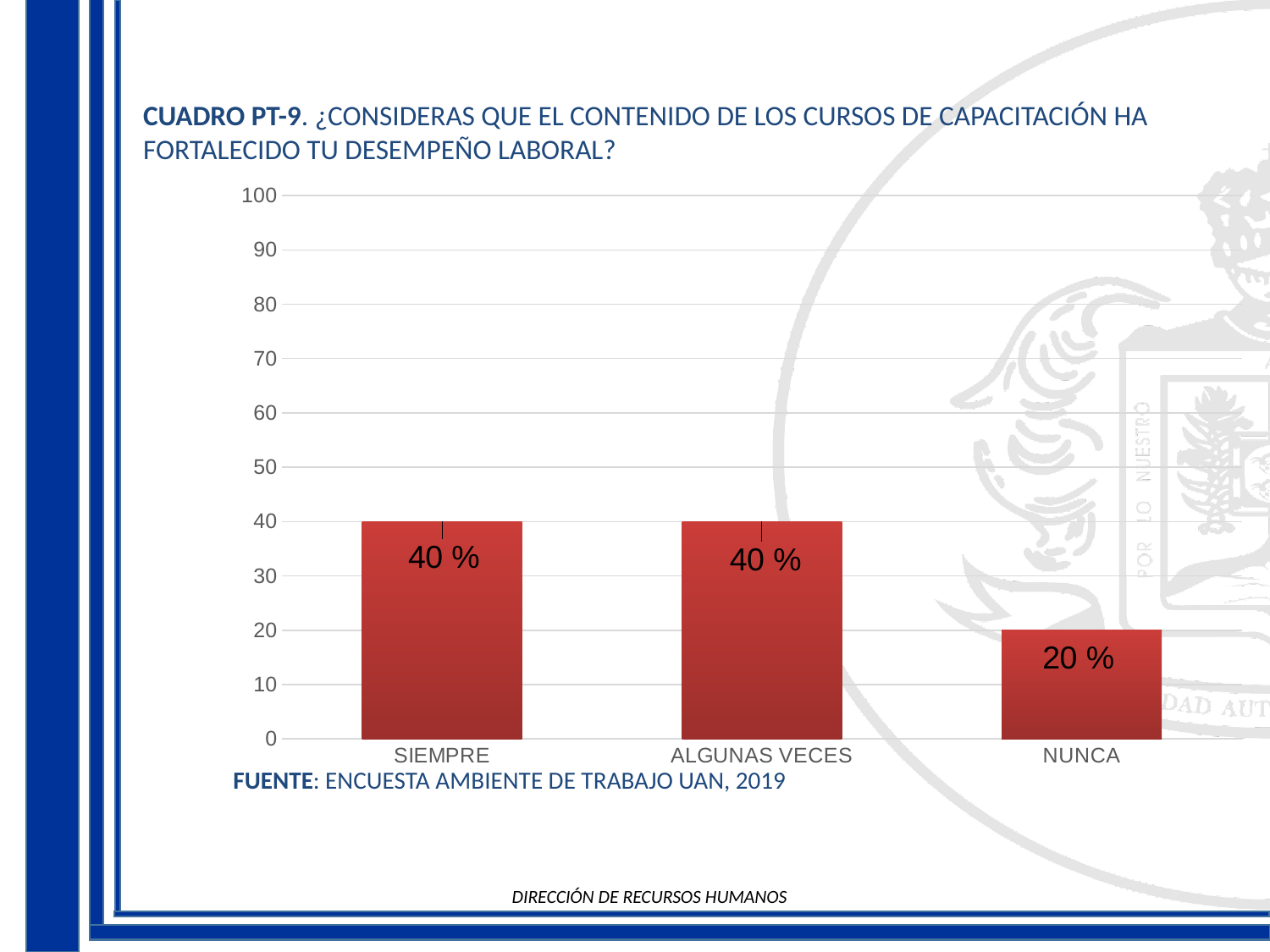
What kind of chart is shown on the slide? bar chart How many categories are shown on the x axis? 3 What is the value for NUNCA? 20 % What source is cited below the chart? ENCUESTA AMBIENTE DE TRABAJO UAN, 2019 Which is larger, the value for ALGUNAS VECES or the value for NUNCA? ALGUNAS VECES Is the value for NUNCA greater or less than 30? less What is the value for ALGUNAS VECES? 40 % Is the value for SIEMPRE greater or less than 50? less What is the difference between the values for SIEMPRE and NUNCA? 20 % What is the value for SIEMPRE? 40 % What is the maximum value shown on the y axis? 100 Which category has the lowest value? NUNCA